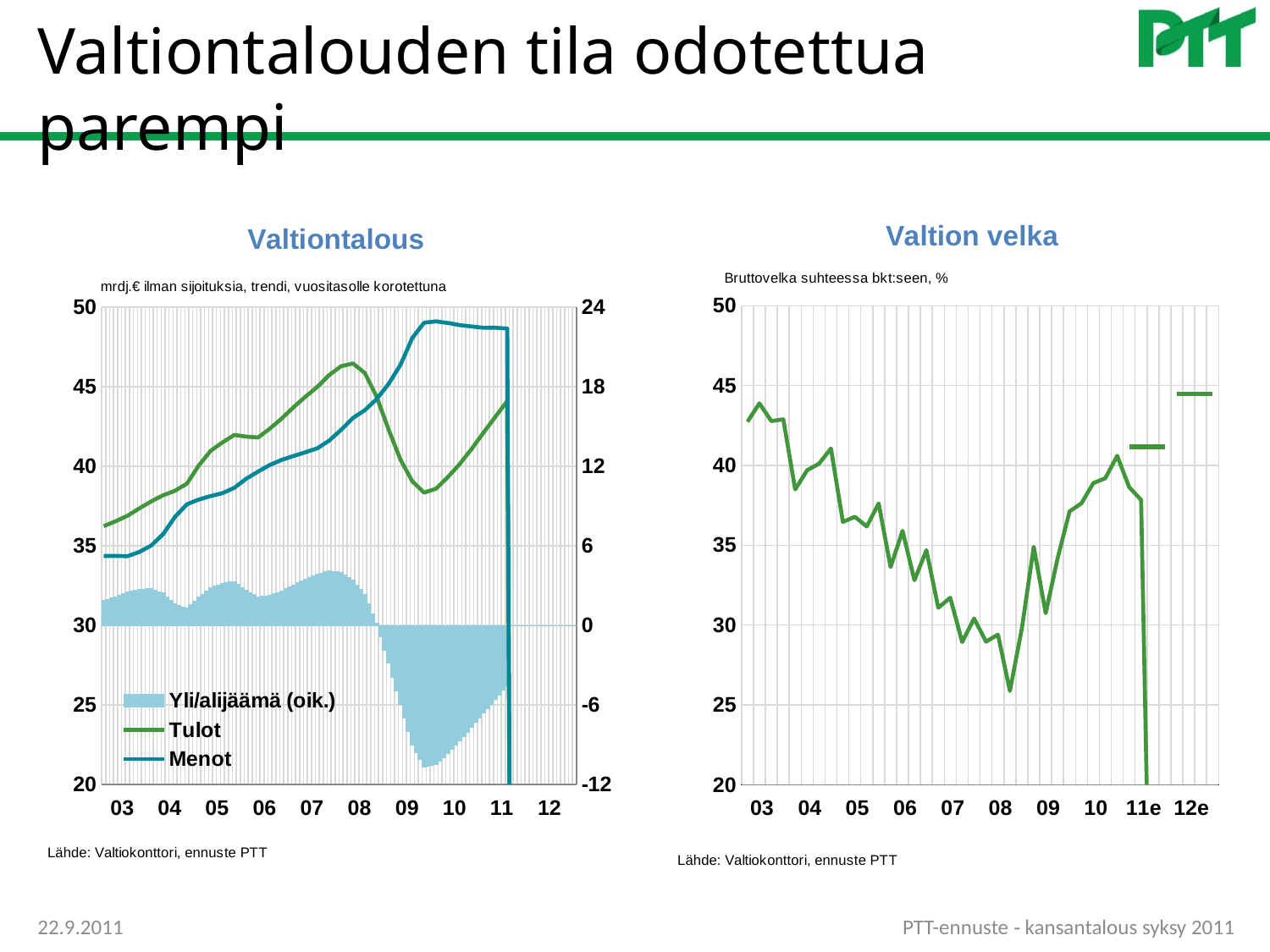
In the 'Valtion velka' chart, does the debt ratio rise or fall from 03 to 08? fall In the 'Valtiontalous' chart, does the Menot line rise or fall from 03 to 10? rise In the 'Valtiontalous' chart, which series is drawn as a shaded area rather than a line? Yli/alijäämä (oik.) In the 'Valtion velka' chart, is the forecast marker for 12e greater or less than 40? greater What is the subtitle printed under the 'Valtion velka' chart title? Bruttovelka suhteessa bkt:seen, % How many series does the legend of the 'Valtiontalous' chart list? 3 In the 'Valtiontalous' chart, is the Menot value at 10 greater or less than 45 on the left axis? greater In the 'Valtiontalous' chart, is the Tulot value at 08 greater or less than 45 on the left axis? greater What kind of chart is the 'Valtion velka' chart? line chart